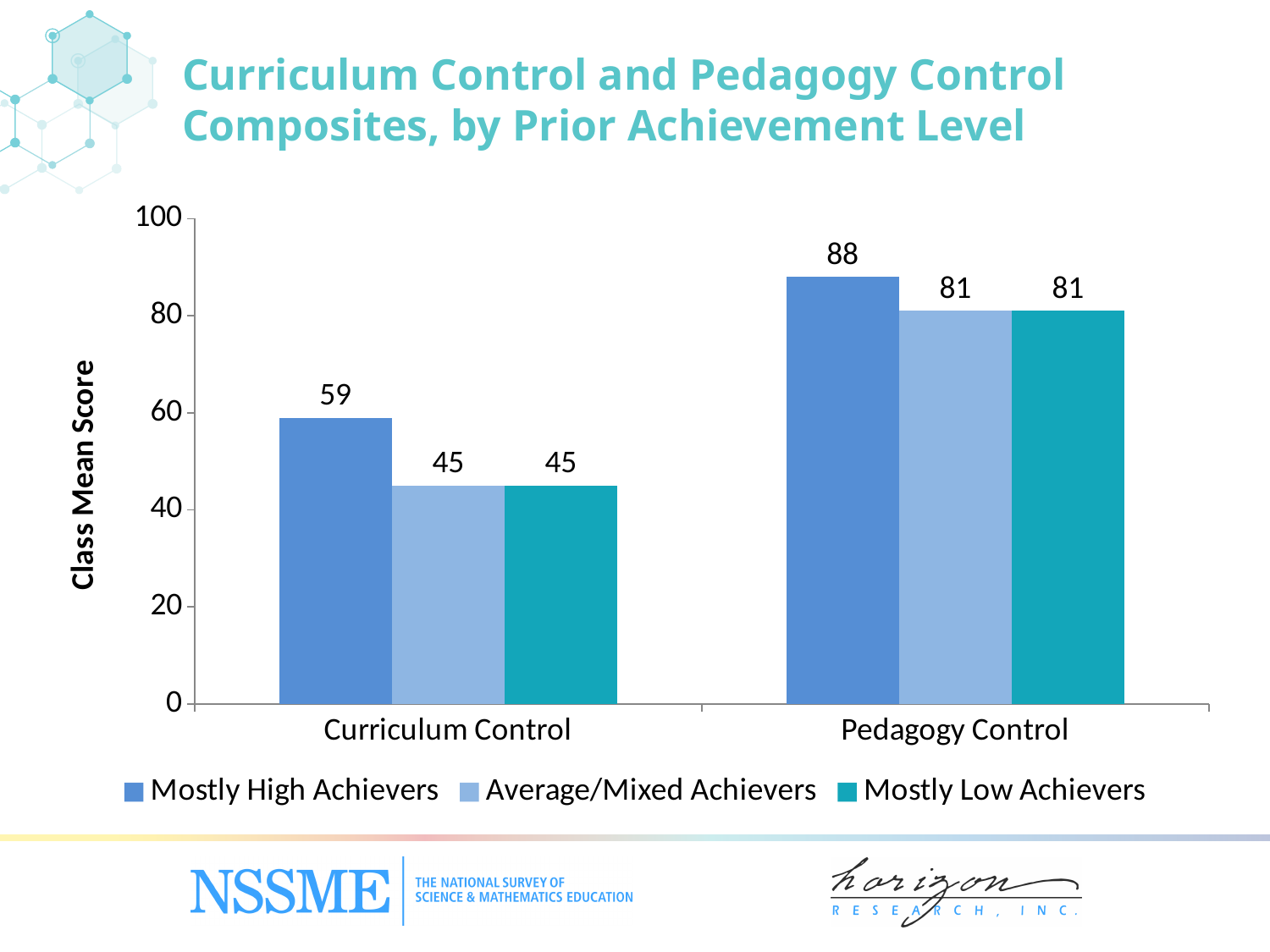
What is the class mean score for Average/Mixed Achievers on the Pedagogy Control composite? 81 Which composite has the lowest class mean score for Mostly High Achievers? Curriculum Control What is the class mean score for Mostly Low Achievers on the Curriculum Control composite? 45 What is the difference between the Pedagogy Control and Curriculum Control scores for Mostly Low Achievers? 36 Which prior achievement level has the highest class mean score on the Pedagogy Control composite? Mostly High Achievers How many composite categories are shown on the x axis? 2 How many series does the legend list? 3 What is the class mean score for Mostly High Achievers on the Curriculum Control composite? 59 What kind of chart is shown on the slide? Bar chart What is the difference between the Mostly High Achievers score and the Average/Mixed Achievers score on the Curriculum Control composite? 14 Which is larger: the Mostly High Achievers score on Curriculum Control or the Mostly Low Achievers score on Pedagogy Control? Mostly Low Achievers score on Pedagogy Control What is the label of the y axis? Class Mean Score